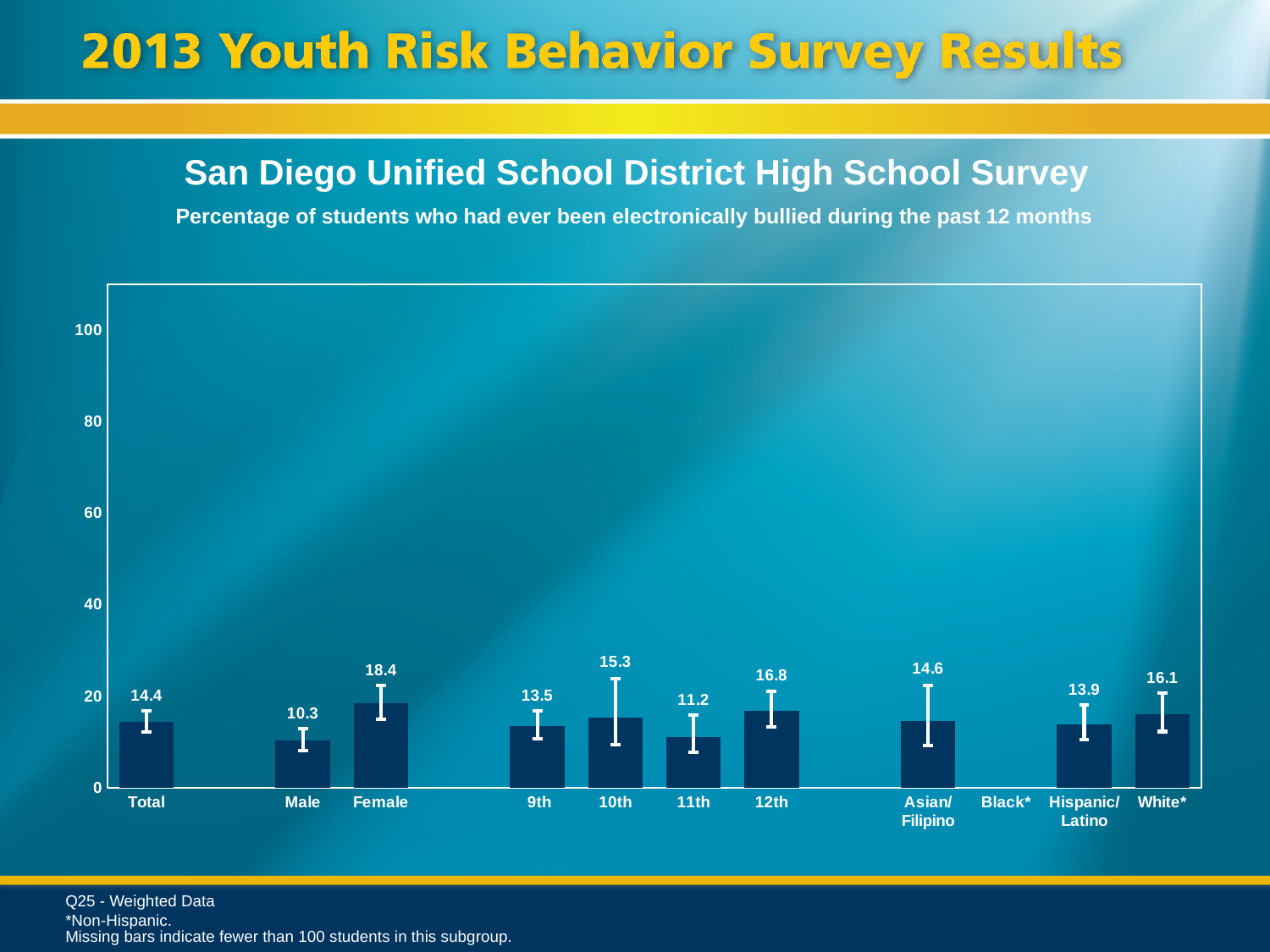
What is the value for Female? 18.4 What kind of chart is shown? bar chart Which category has the lowest value among those with bars? Male What is the value for Total? 14.4 Which is larger, the value for 10th or the value for 12th? 12th What is the difference between the 12th and 9th values? 3.3 What is the value for 11th? 11.2 What is the value for Hispanic/Latino? 13.9 Which category has no bar shown? Black* Which category has the highest value? Female Is the value for White* greater or less than 20? less What is the difference between the Female and Male values? 8.1